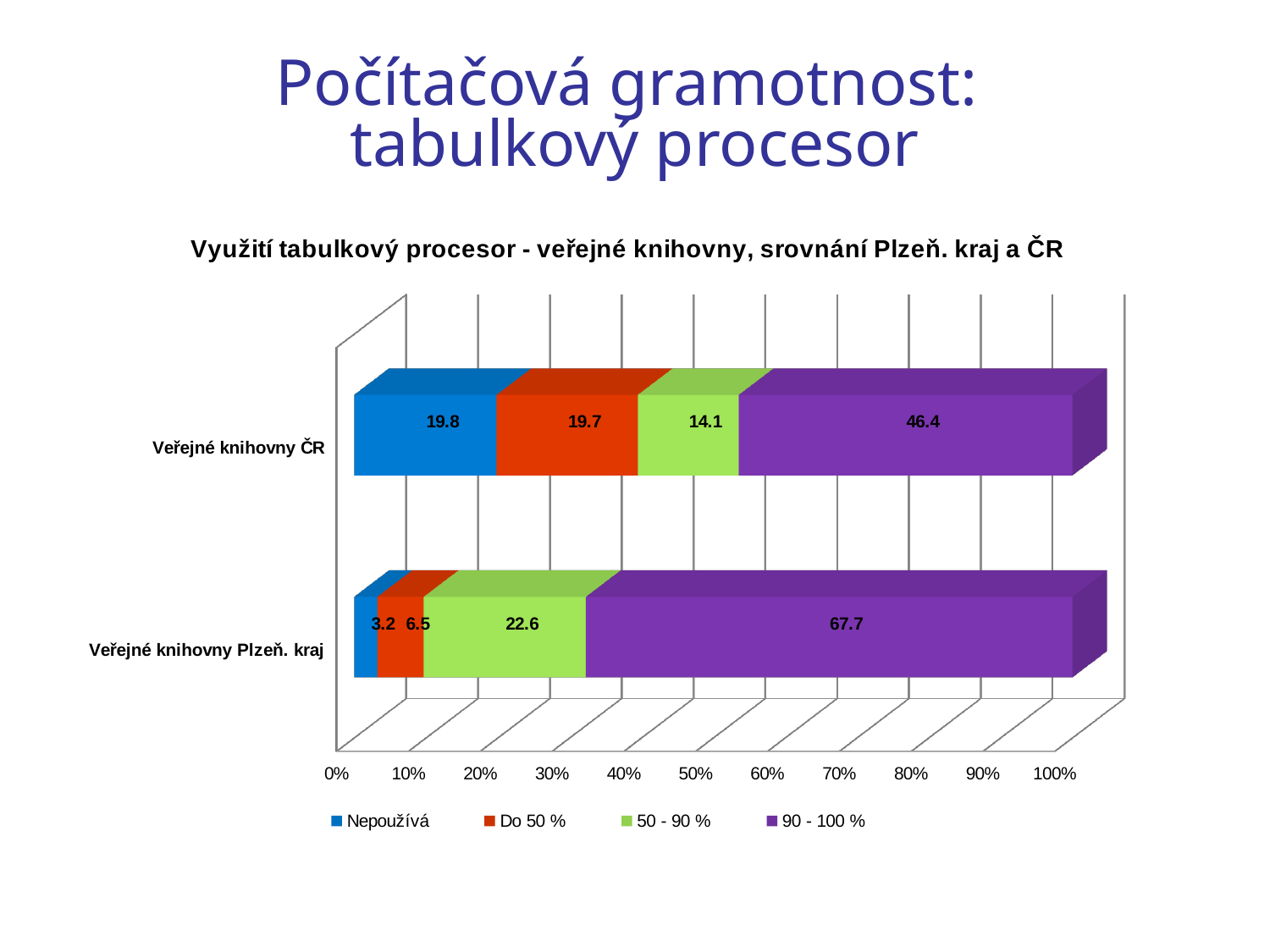
How many series does the legend list? 4 Which segment is the largest in the 'Veřejné knihovny ČR' bar? 90 - 100 % What is the value of the 'Nepoužívá' segment for 'Veřejné knihovny ČR'? 19.8 Which segment is the smallest in the 'Veřejné knihovny Plzeň. kraj' bar? Nepoužívá What is the difference between the '90 - 100 %' values for 'Veřejné knihovny Plzeň. kraj' and 'Veřejné knihovny ČR'? 21.3 Which category has the larger '50 - 90 %' value, 'Veřejné knihovny ČR' or 'Veřejné knihovny Plzeň. kraj'? Veřejné knihovny Plzeň. kraj What is the title of the chart? Využití tabulkový procesor - veřejné knihovny, srovnání Plzeň. kraj a ČR What is the value of the '50 - 90 %' segment for 'Veřejné knihovny ČR'? 14.1 What is the value of the 'Do 50 %' segment for 'Veřejné knihovny Plzeň. kraj'? 6.5 What kind of chart is shown on the slide? Stacked bar chart What is the value of the '90 - 100 %' segment for 'Veřejné knihovny Plzeň. kraj'? 67.7 How many categories (bars) are plotted on the chart? 2